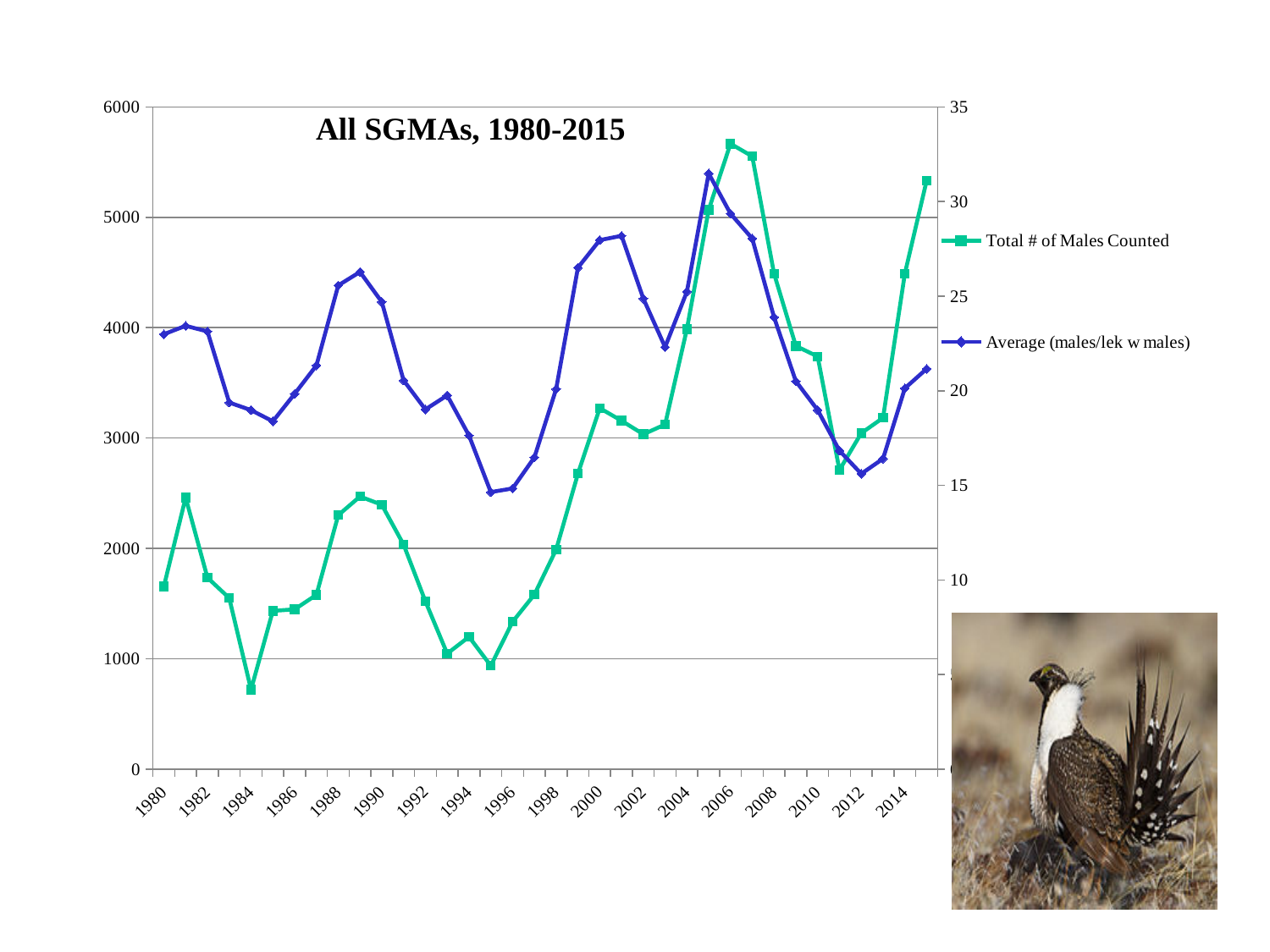
Is the Total # of Males Counted in 2015 greater or less than 5000? greater In which year is the Total # of Males Counted lowest? 1984 Is the Total # of Males Counted in 1984 greater or less than 1000? less Does the Total # of Males Counted rise or fall from 2011 to 2015? rise Is the Average (males/lek w males) in 2005 greater or less than 30? greater What is the title of the chart? All SGMAs, 1980-2015 How many series does the legend list? 2 Which year has a larger Total # of Males Counted, 1981 or 1984? 1981 In which year is the Average (males/lek w males) highest? 2005 What kind of chart is shown on the slide? line chart Which series is drawn in green with square markers? Total # of Males Counted